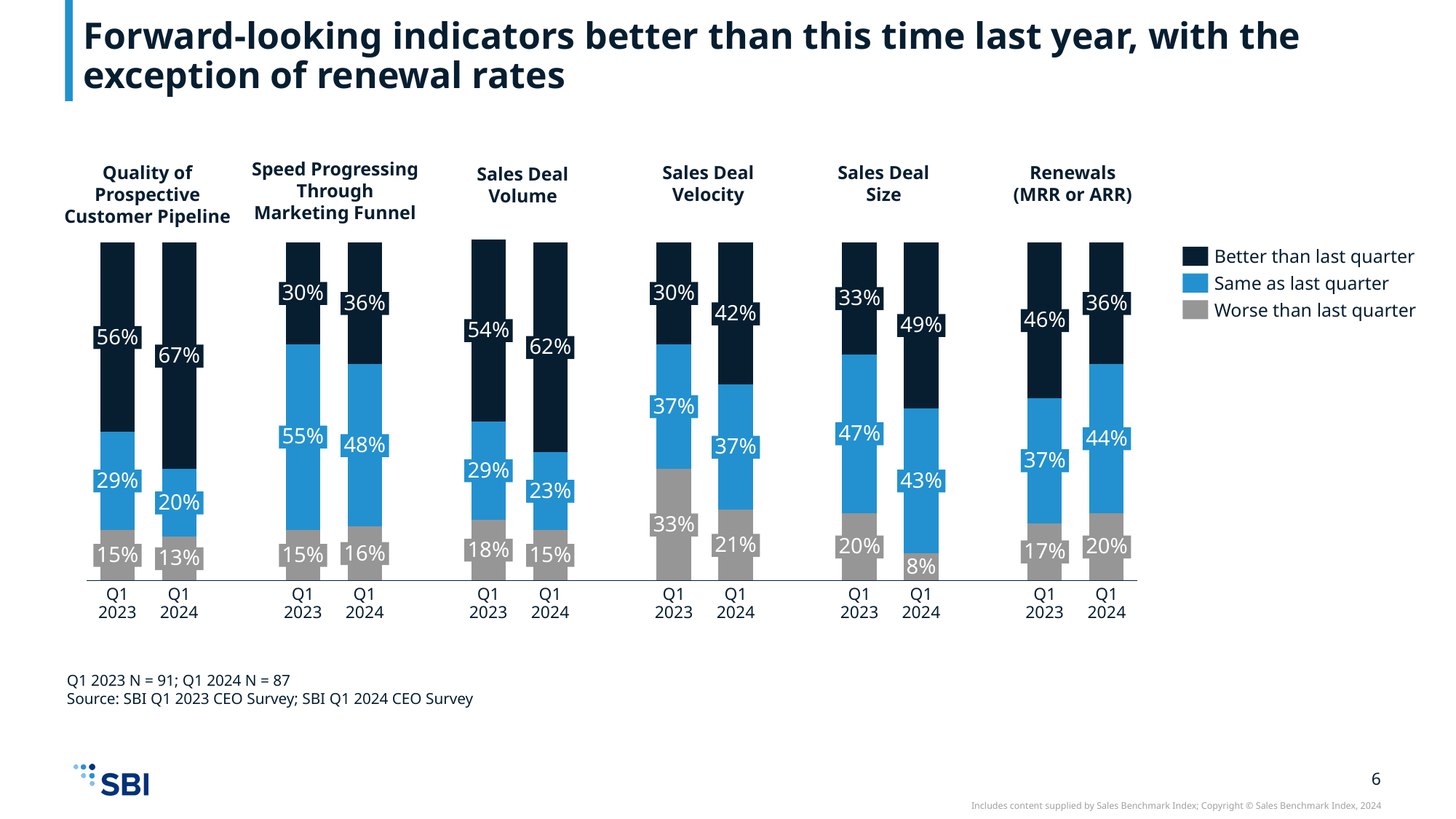
Which colour represents 'Worse than last quarter' in the legend? Grey In the Sales Deal Volume chart, by how many percentage points did 'Better than last quarter' change from Q1 2023 to Q1 2024? 8 percentage points In the Sales Deal Velocity chart, what is the 'Worse than last quarter' value for Q1 2023? 33% How many series does the legend list? 3 In the Sales Deal Velocity chart, what is the total of the Q1 2024 stacked bar? 100% In the Sales Deal Size chart, which segment is smallest in the Q1 2024 bar? Worse than last quarter In the Sales Deal Size chart, what is the 'Worse than last quarter' value for Q1 2024? 8% In the Quality of Prospective Customer Pipeline chart, what share of respondents said 'Better than last quarter' in Q1 2024? 67% In the Renewals (MRR or ARR) chart, which year has the larger 'Better than last quarter' share, Q1 2023 or Q1 2024? Q1 2023 What kind of chart is used on this slide? Stacked bar chart In the Speed Progressing Through Marketing Funnel chart, which segment is largest in the Q1 2023 bar? Same as last quarter In the Renewals (MRR or ARR) chart, what is the 'Same as last quarter' value for Q1 2024? 44%